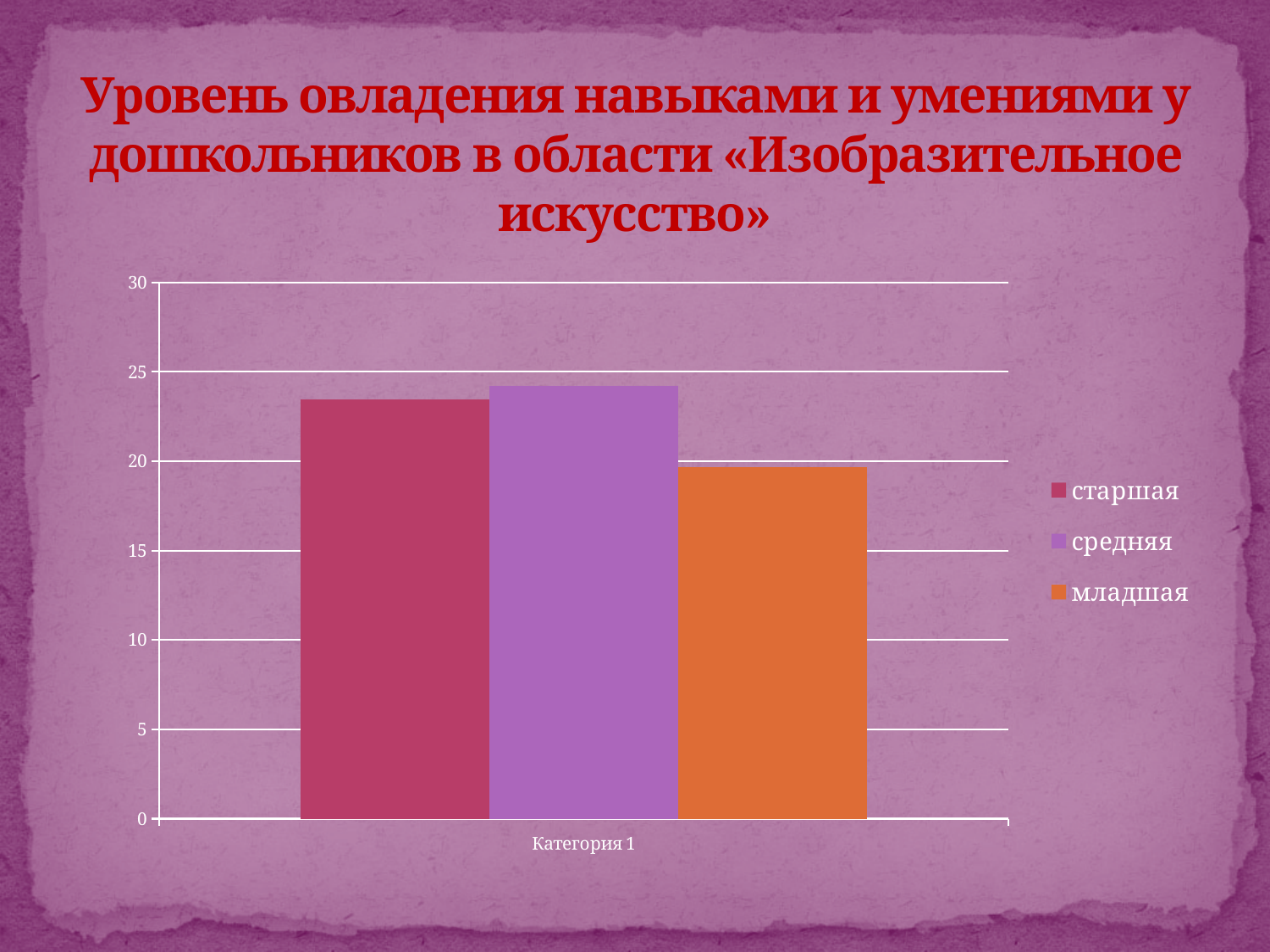
How many series does the legend list? 3 Is the value for средняя greater or less than 25? less How many categories are shown on the x axis? 1 Which series is shown in orange? младшая Which series has the lowest bar? младшая What is the label of the category on the x axis? Категория 1 Which is larger, the value for старшая or the value for младшая? старшая Is the value for младшая greater or less than 15? greater What kind of chart is shown on the slide? bar chart Which is larger, the value for средняя or the value for младшая? средняя Which series has the highest bar? средняя Is the value for старшая greater or less than 20? greater